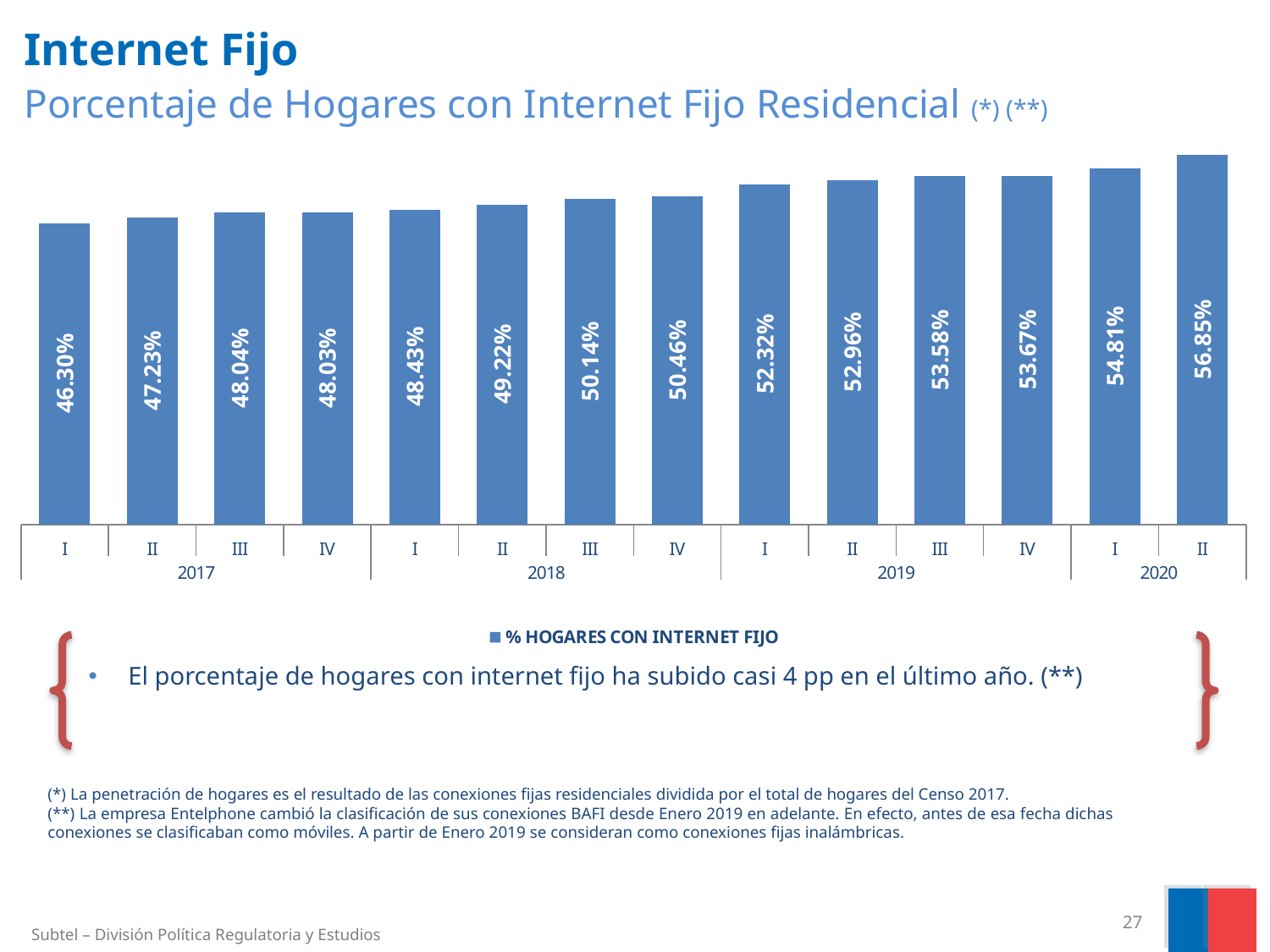
Do the values generally rise or fall from 2017 to 2020? Rise What is the value for quarter III of 2019? 53.58% What kind of chart is shown on the slide? Bar chart What is the value for quarter I of 2017? 46.30% How many series does the legend list? 1 Which quarter has the highest percentage of households with fixed internet? II 2020 How many quarters (bars) are plotted in the chart? 14 Which quarter has the lowest percentage of households with fixed internet? I 2017 What is the difference between the values for quarter II of 2020 and quarter II of 2019? 3.89% What is the value for quarter II of 2020? 56.85% What is the legend entry for the series shown? % HOGARES CON INTERNET FIJO Which is larger, the value for quarter IV of 2018 or quarter I of 2019? I 2019